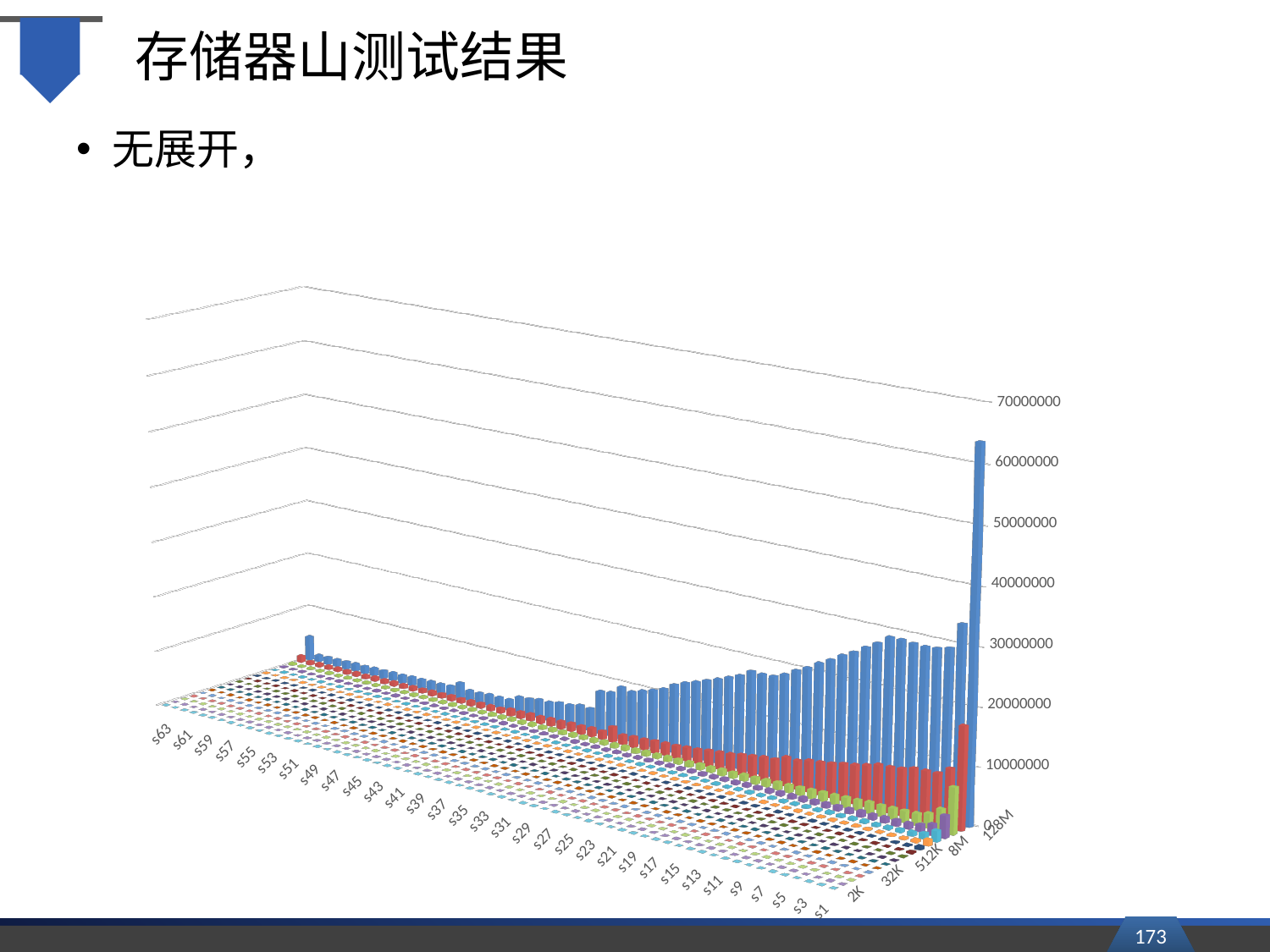
Which size category is labelled at the front of the depth axis, closest to the viewer? 2K How many size categories (2K, 32K, 512K, 8M, 128M) are labelled on the depth axis of the chart? 5 Which stride category has the tallest bar in the front (blue) row of the chart? s1 Is the tallest bar in the chart (blue, at s1) greater or less than 50000000? greater Is the tallest bar in the chart (blue, at s1) greater or less than 70000000? less What is the lowest labelled tick on the vertical axis of the chart? 0 What kind of chart is shown on the slide? bar chart What is the highest value shown on the vertical axis of the chart? 70000000 In the front (blue) row, is the bar at s1 larger or smaller than the bar at s3? larger